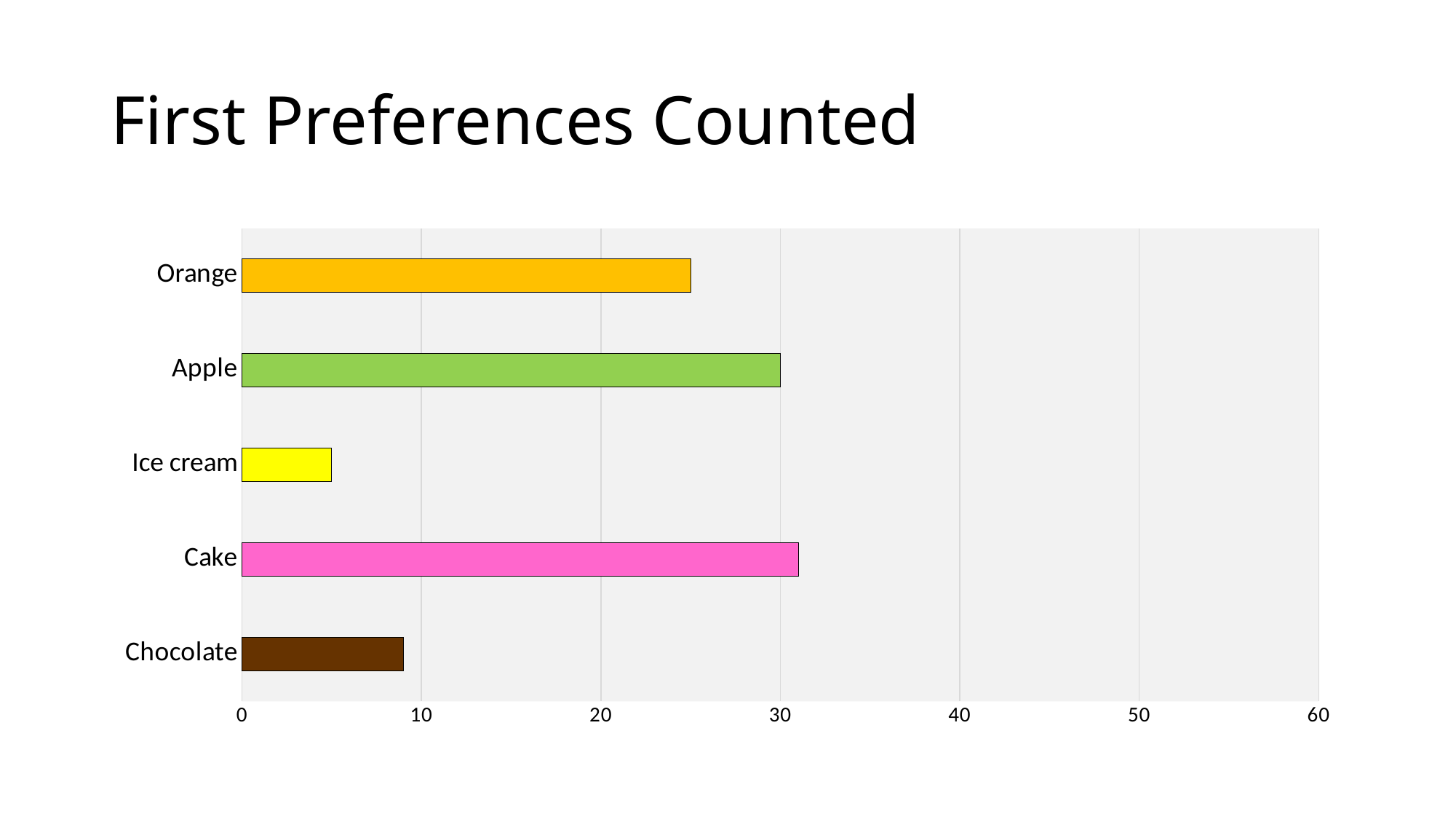
Is the value for Ice cream greater or less than 10? less Which is larger, the value for Apple or the value for Orange? Apple Which category has the highest value? Cake Is the value for Orange greater or less than 20? greater Is the value for Chocolate greater or less than 10? less What kind of chart is shown on the slide? bar chart What is the title of the slide? First Preferences Counted Which category has the lowest value? Ice cream How many categories are shown in the chart? 5 What is the value for Apple? 30 Which is larger, the value for Orange or the value for Chocolate? Orange